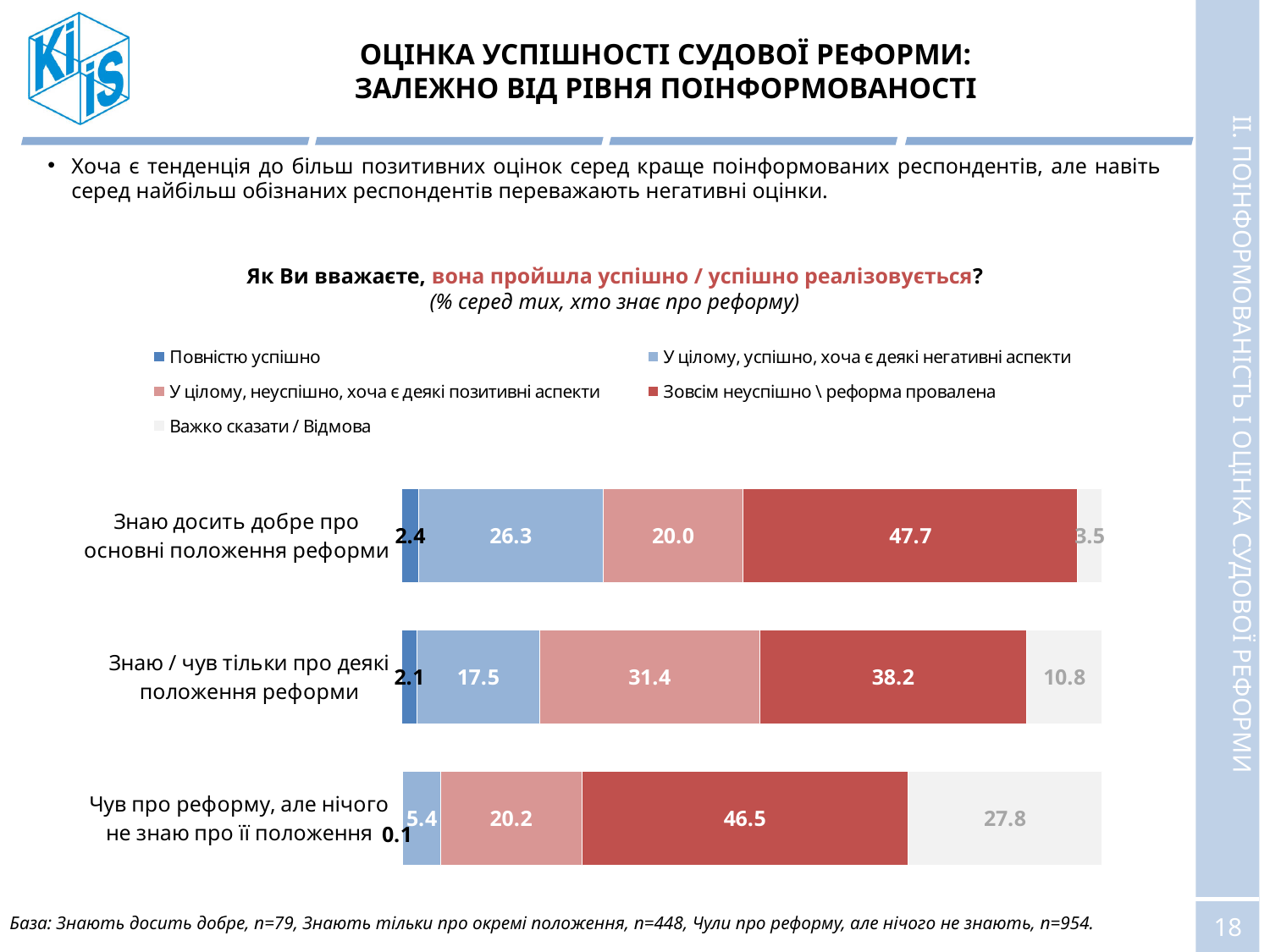
Which category has the lowest value for "Повністю успішно"? Чув про реформу, але нічого не знаю про її положення Which category has the highest value for "Важко сказати / Відмова"? Чув про реформу, але нічого не знаю про її положення How many series does the legend list? 5 Which colour represents "Зовсім неуспішно \ реформа провалена" in the legend? Dark red What is the value of "Важко сказати / Відмова" for "Чув про реформу, але нічого не знаю про її положення"? 27.8 Which is larger: the "Зовсім неуспішно \ реформа провалена" value for "Знаю досить добре про основні положення реформи" or for "Знаю / чув тільки про деякі положення реформи"? Знаю досить добре про основні положення реформи How many categories (respondent groups) are plotted on the chart? 3 What is the total of the stacked bar for "Знаю / чув тільки про деякі положення реформи"? 100.0 What is the value of "У цілому, успішно, хоча є деякі негативні аспекти" for "Знаю / чув тільки про деякі положення реформи"? 17.5 What is the value of "Зовсім неуспішно \ реформа провалена" for "Знаю досить добре про основні положення реформи"? 47.7 What kind of chart is shown on the slide? Stacked bar chart What is the difference between the "У цілому, неуспішно, хоча є деякі позитивні аспекти" values for "Знаю / чув тільки про деякі положення реформи" and "Знаю досить добре про основні положення реформи"? 11.4